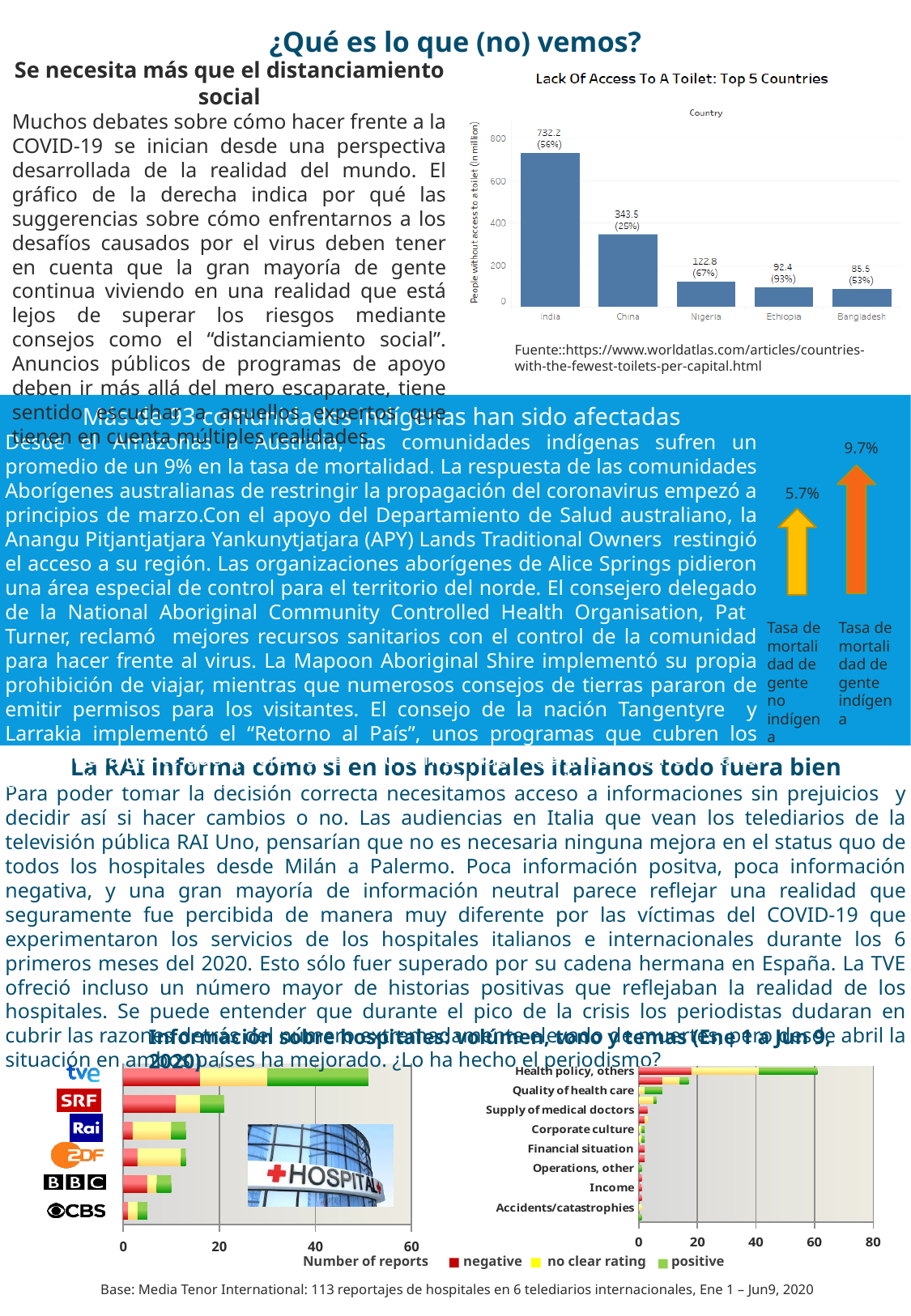
In the 'Lack Of Access To A Toilet: Top 5 Countries' chart, do the values rise or fall from India to Bangladesh along the x axis? fall How many series does the legend list for the hospital reports charts at the bottom of the slide? 3 In the 'Lack Of Access To A Toilet: Top 5 Countries' chart, which has more people without toilet access, Nigeria or Ethiopia? Nigeria In the 'Lack Of Access To A Toilet: Top 5 Countries' chart, what percentage is shown for Ethiopia? 93% What type of chart is 'Lack Of Access To A Toilet: Top 5 Countries'? bar chart In the 'Lack Of Access To A Toilet: Top 5 Countries' chart, what is the difference in millions between India and China? 388.7 In the 'Lack Of Access To A Toilet: Top 5 Countries' chart, how many people in India lack access to a toilet (in million)? 732.2 In the 'Lack Of Access To A Toilet: Top 5 Countries' chart, which country has the lowest number of people without access to a toilet? Bangladesh How many countries are shown in the 'Lack Of Access To A Toilet: Top 5 Countries' chart? 5 In the arrow graphic on the blue panel, what is the difference between the mortality rate for indigenous people and non-indigenous people? 4.0% In the arrow graphic on the blue panel, what is the mortality rate shown for indigenous people (gente indígena)? 9.7% In the 'Lack Of Access To A Toilet: Top 5 Countries' chart, which country has the highest number of people without access to a toilet? India